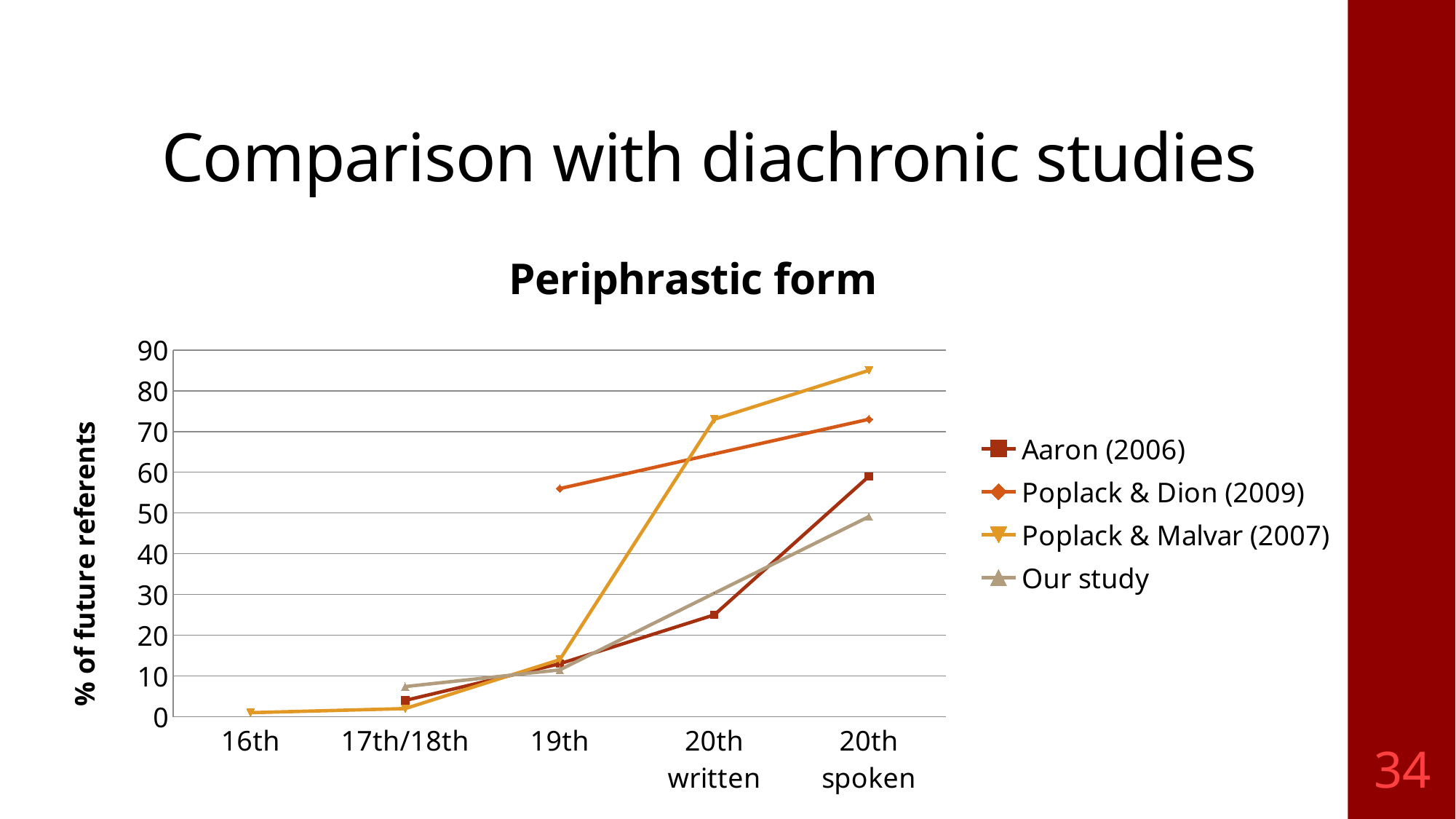
Which series has the highest value at 20th spoken? Poplack & Malvar (2007) Is the value for Our study at 20th spoken greater or less than 40? greater Is the value for Poplack & Dion (2009) at 19th greater or less than 50? greater What is the title of the chart? Periphrastic form Is the value for Poplack & Malvar (2007) at 20th written greater or less than 60? greater What kind of chart is shown on the slide? line chart Which series has the lowest value at 20th spoken? Our study Do the values for Poplack & Malvar (2007) rise or fall from 16th to 20th spoken? rise At 20th written, which is larger: Aaron (2006) or Our study? Our study How many series does the legend list? 4 How many categories are shown on the x axis? 5